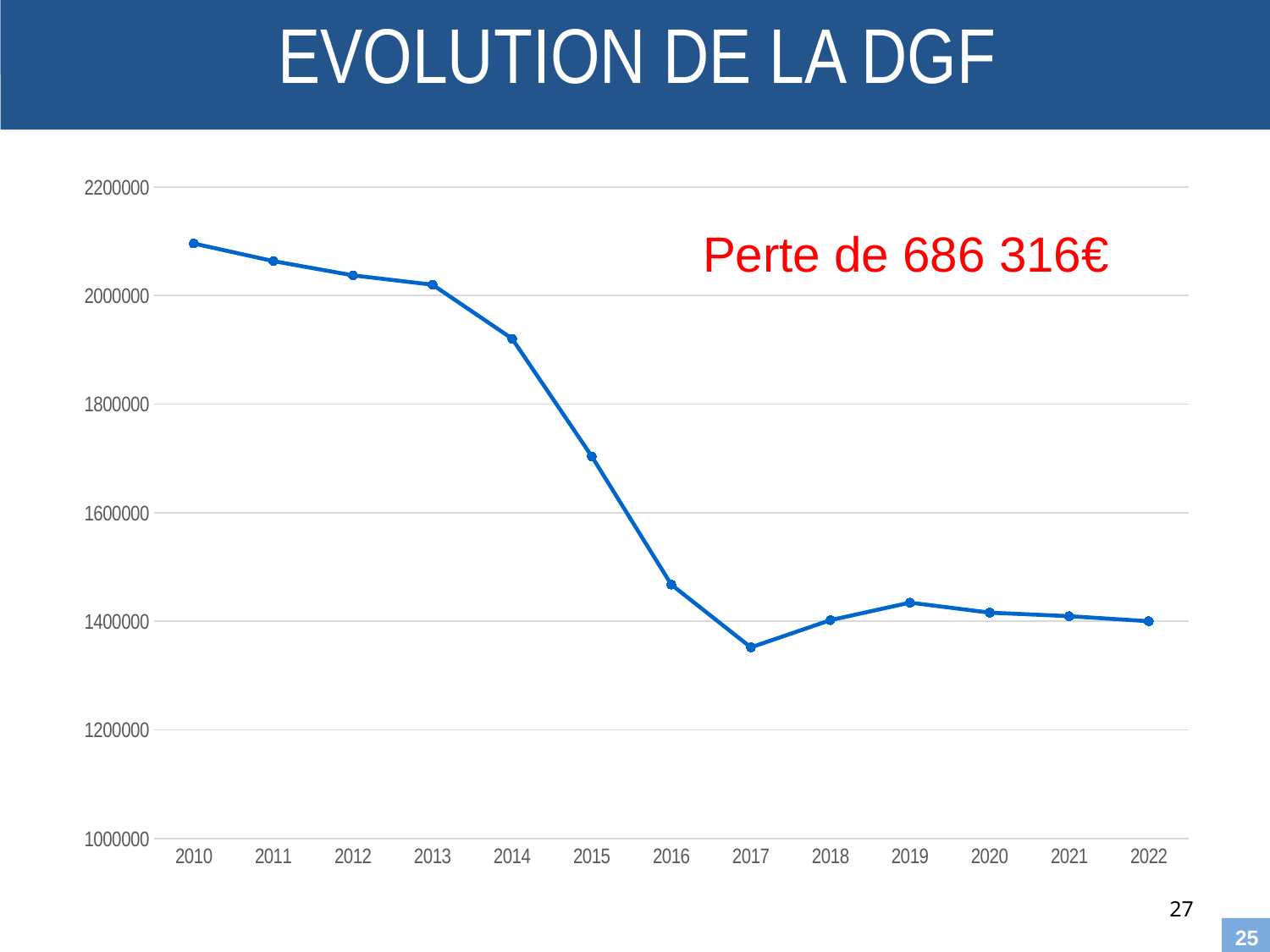
Which year has the lowest value? 2017 Is the value for 2015 greater or less than 1600000? greater Is the value for 2016 greater or less than 1600000? less What is the title of the slide? EVOLUTION DE LA DGF Which is larger, the value for 2015 or the value for 2016? 2015 Is the value for 2017 greater or less than 1400000? less Overall, do the values rise or fall from 2010 to 2022? fall How many years are plotted along the x axis? 13 What kind of chart is shown on the slide? line chart What loss amount is written in red on the chart? Perte de 686 316€ Which year has the highest value? 2010